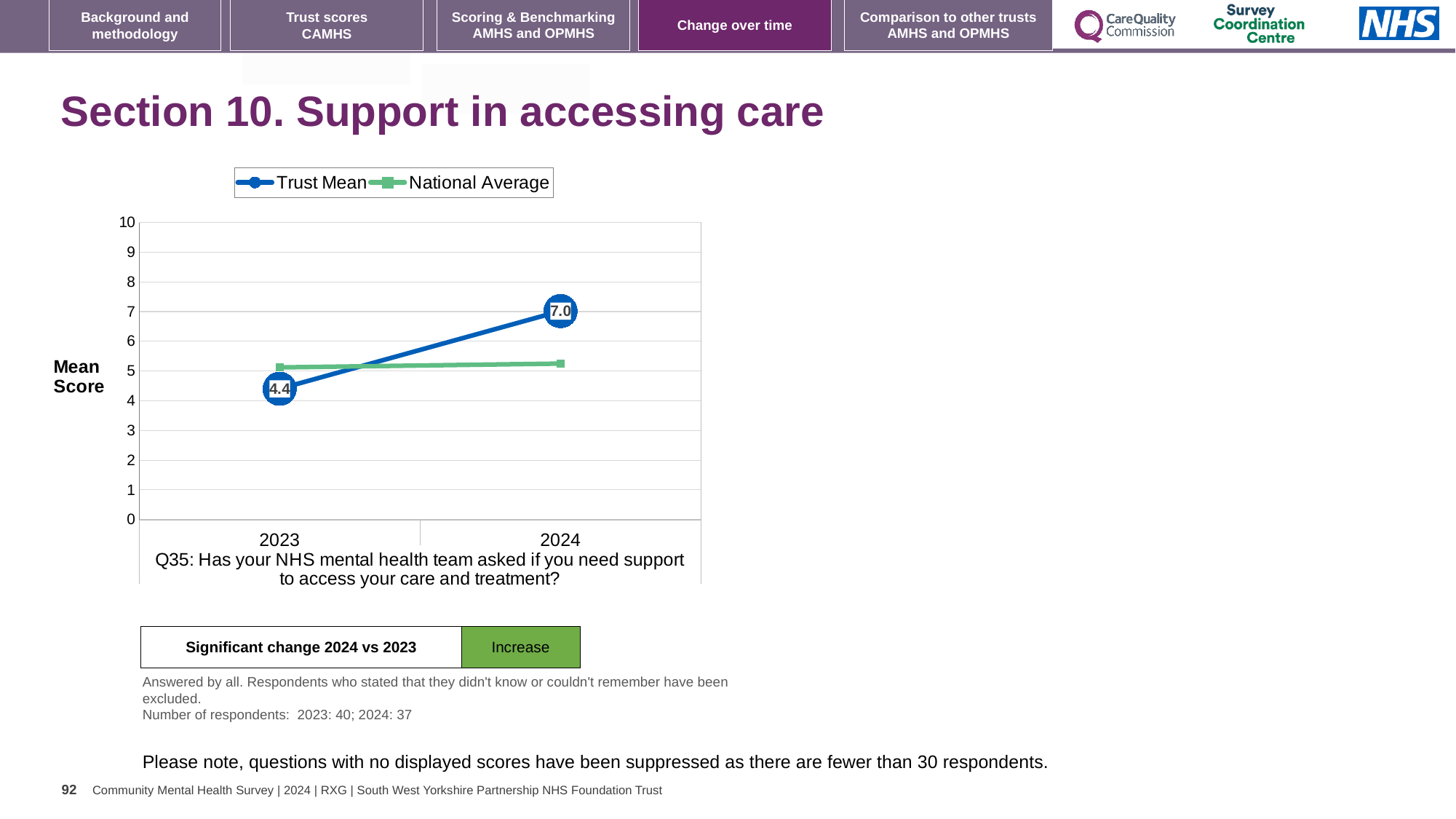
In 2023, which is higher: the Trust Mean or the National Average? National Average What type of chart is shown on the slide? line chart By how much did the Trust Mean score change from 2023 to 2024? 2.6 In 2024, which is higher: the Trust Mean or the National Average? Trust Mean Does the Trust Mean line rise or fall from 2023 to 2024? rises Which year has the higher Trust Mean score, 2023 or 2024? 2024 What is the Trust Mean score for 2023? 4.4 Is the National Average value for 2023 greater or less than 6? less How many years are shown on the x axis of the chart? 2 What is the Trust Mean score for 2024? 7.0 Is the National Average value for 2024 greater or less than 4? greater How many series does the chart legend list? 2